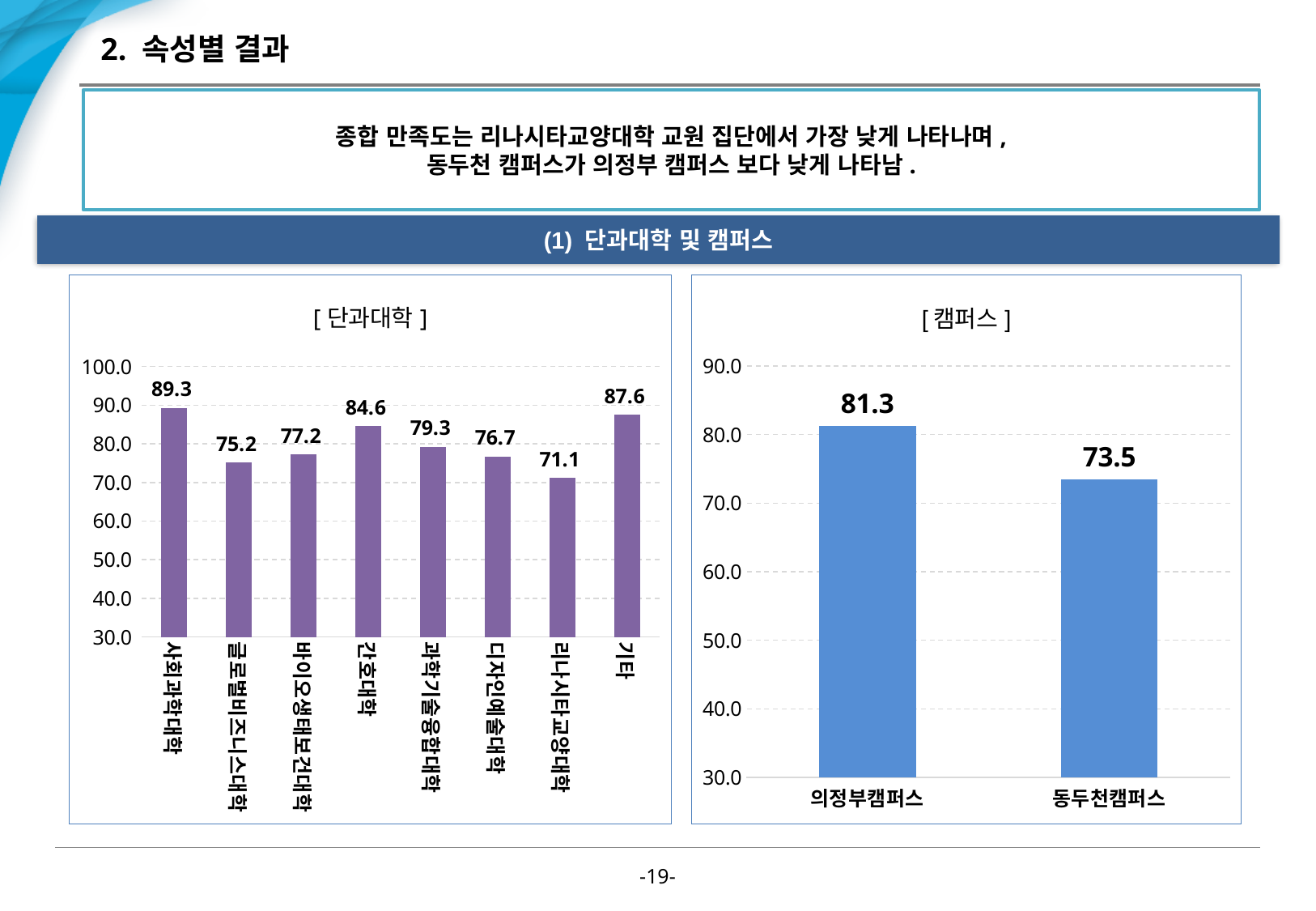
In the [캠퍼스] chart, which campus has the higher value? 의정부캠퍼스 In the [단과대학] chart, which category has the highest value? 사회과학대학 In the [단과대학] chart, what is the value for 간호대학? 84.6 How many categories are shown in the [단과대학] chart? 8 In the [캠퍼스] chart, what is the value for 동두천캠퍼스? 73.5 In the [단과대학] chart, which is larger, 과학기술융합대학 or 디자인예술대학? 과학기술융합대학 In the [단과대학] chart, what is the difference between 사회과학대학 and 리나시타교양대학? 18.2 In the [캠퍼스] chart, what is the difference between 의정부캠퍼스 and 동두천캠퍼스? 7.8 In the [단과대학] chart, which category has the lowest value? 리나시타교양대학 In the [단과대학] chart, what is the value for 기타? 87.6 What type of chart is the [캠퍼스] chart? Bar chart In the [단과대학] chart, what is the value for 사회과학대학? 89.3